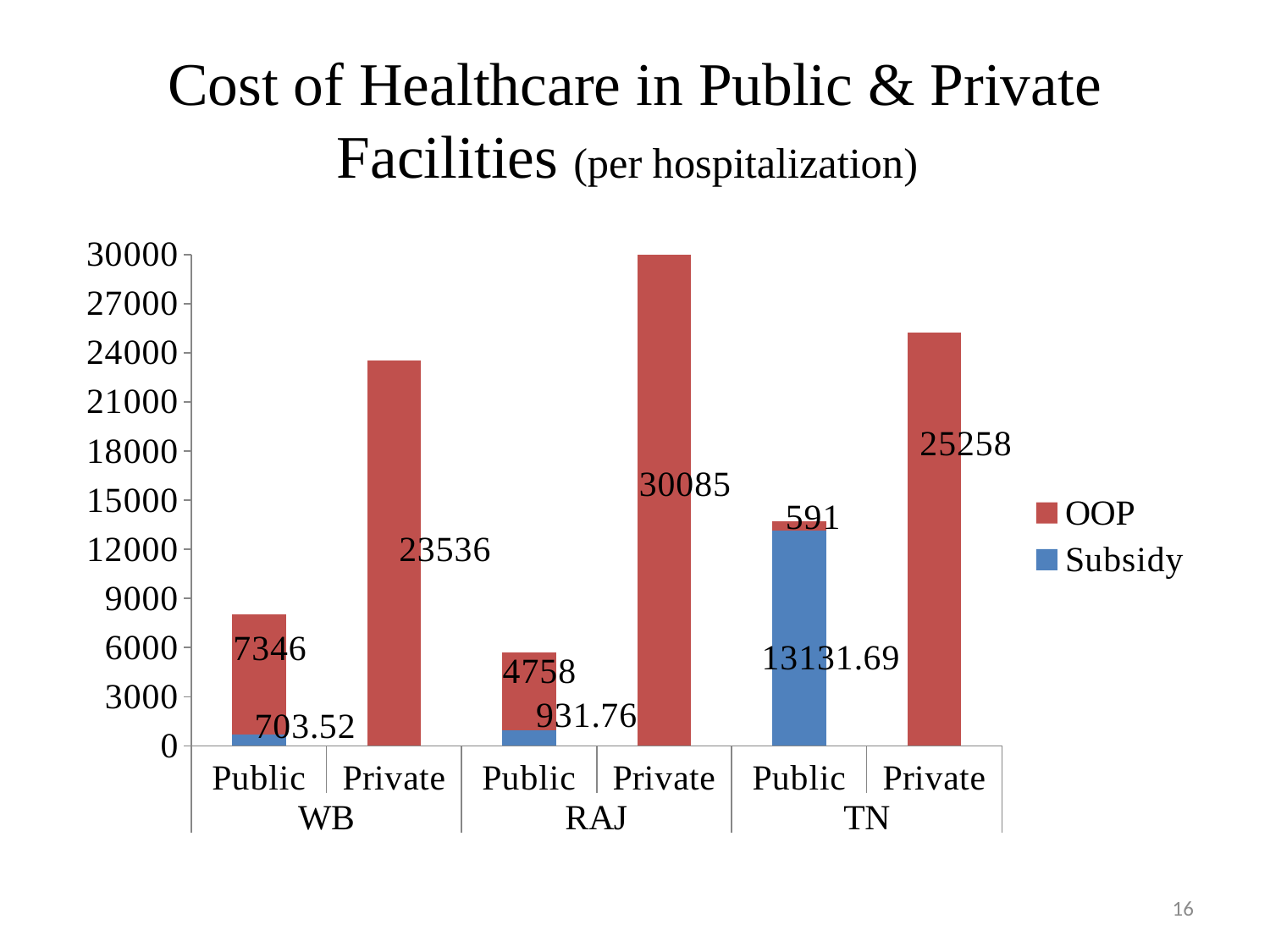
Which colour represents the Subsidy series? Blue What is the Subsidy value for WB Public? 703.52 What is the OOP value for WB Private? 23536 What is the Subsidy value for TN Public? 13131.69 What kind of chart is shown on the slide? Stacked bar chart How many series does the legend list? 2 What is the OOP value for RAJ Public? 4758 Which category has the highest OOP value? RAJ Private What is the total of the stacked bar for TN Public? 13722.69 What is the difference between the OOP values for RAJ Private and TN Private? 4827 Which category has the lowest OOP value? TN Public Which is larger, the OOP value for WB Public or the OOP value for RAJ Public? WB Public